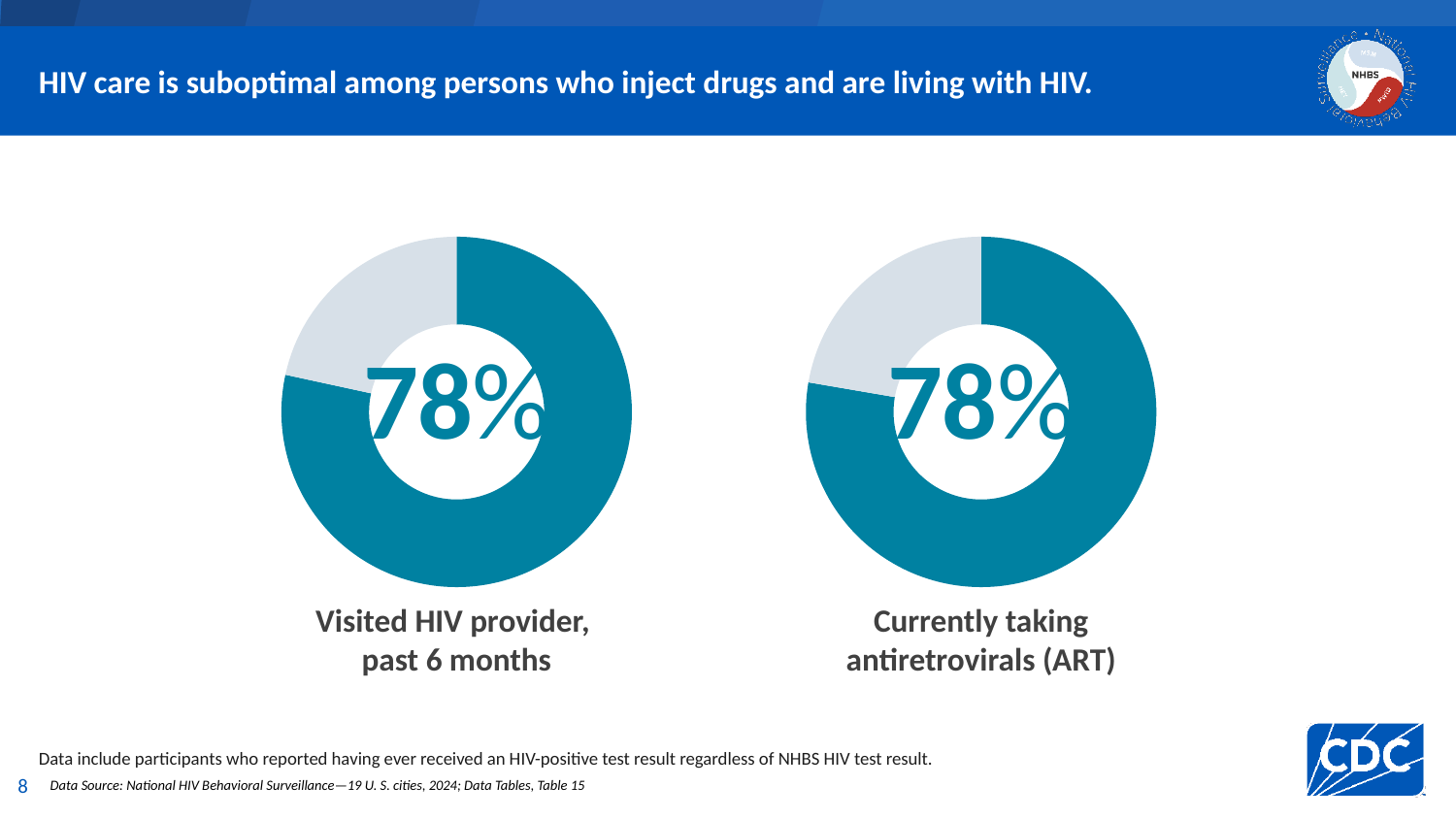
What kind of chart is used to show the 'Visited HIV provider, past 6 months' value? Donut (pie) chart What is the difference between the 'Visited HIV provider, past 6 months' value and the 'Currently taking antiretrovirals (ART)' value? 0 percentage points In the left donut chart, what share of the ring is the light grey (remaining) portion? 22% How many donut charts are shown on the slide? 2 Is the value for 'Currently taking antiretrovirals (ART)' greater or less than 50%? greater What is the title of the slide containing the two donut charts? HIV care is suboptimal among persons who inject drugs and are living with HIV. In the right donut chart, what percentage are currently taking antiretrovirals (ART)? 78% Which is larger: the percentage who visited an HIV provider in the past 6 months or the percentage currently taking ART? They are equal (both 78%) Is the value for 'Visited HIV provider, past 6 months' greater or less than 90%? less In the right donut chart, what share of the ring is not covered by the 78% teal segment? 22% What colour is the segment representing the 78% value in each donut chart? Teal blue In the left donut chart, what percentage of persons who inject drugs and are living with HIV visited an HIV provider in the past 6 months? 78%